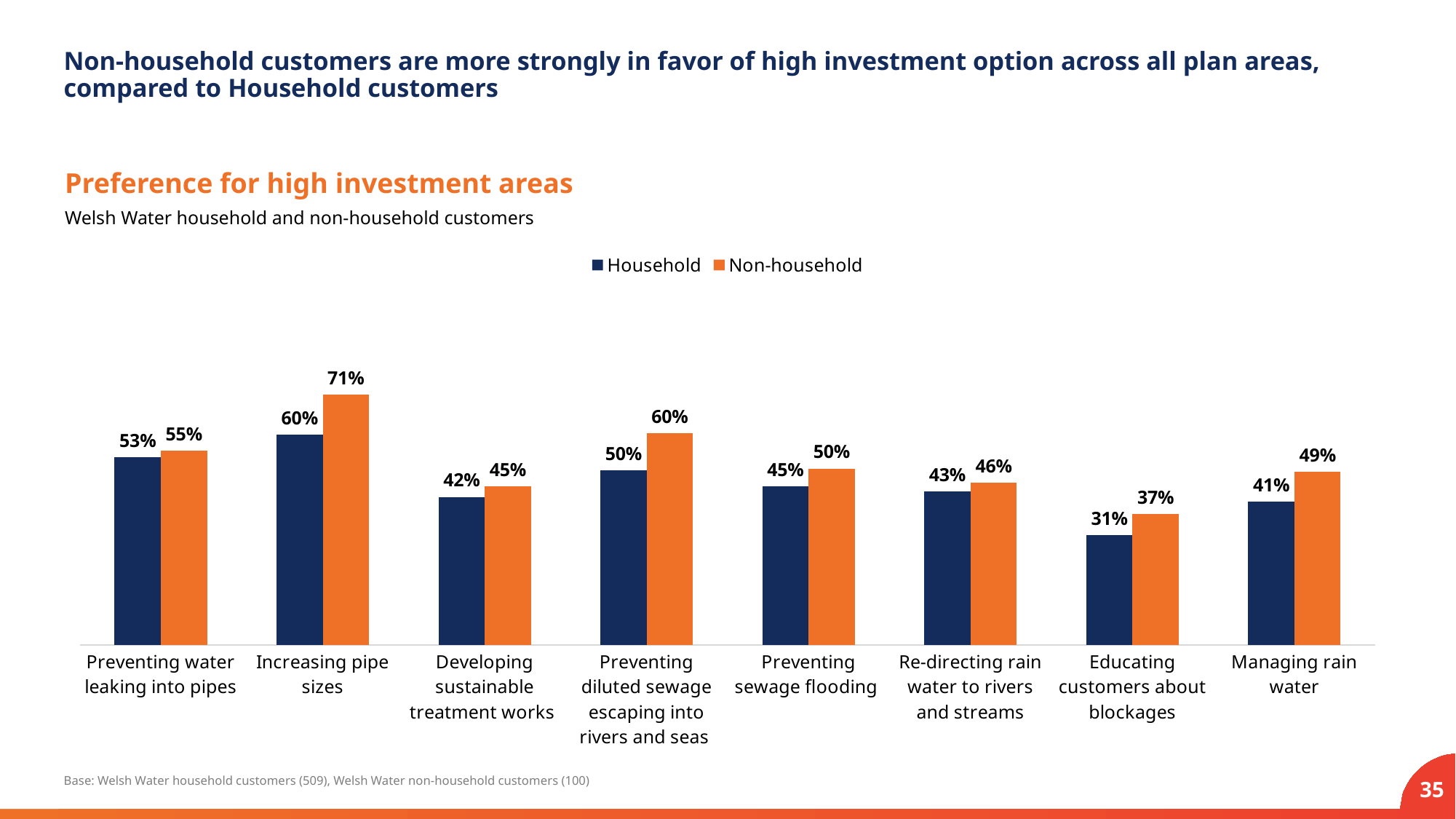
What is the title of the chart? Preference for high investment areas What kind of chart is shown on the slide? Bar chart How many series does the legend list? 2 What is the difference between the Non-household and Household values for Increasing pipe sizes? 11 percentage points Which category has the highest Non-household value? Increasing pipe sizes What is the Household value for Educating customers about blockages? 31% Which is larger: the Household value for Preventing water leaking into pipes or the Household value for Preventing sewage flooding? Preventing water leaking into pipes Which category has the lowest Household value? Educating customers about blockages How many categories are shown on the x axis? 8 What is the Household value for Increasing pipe sizes? 60% What is the difference between the Non-household and Household values for Preventing diluted sewage escaping into rivers and seas? 10 percentage points What is the Non-household value for Managing rain water? 49%